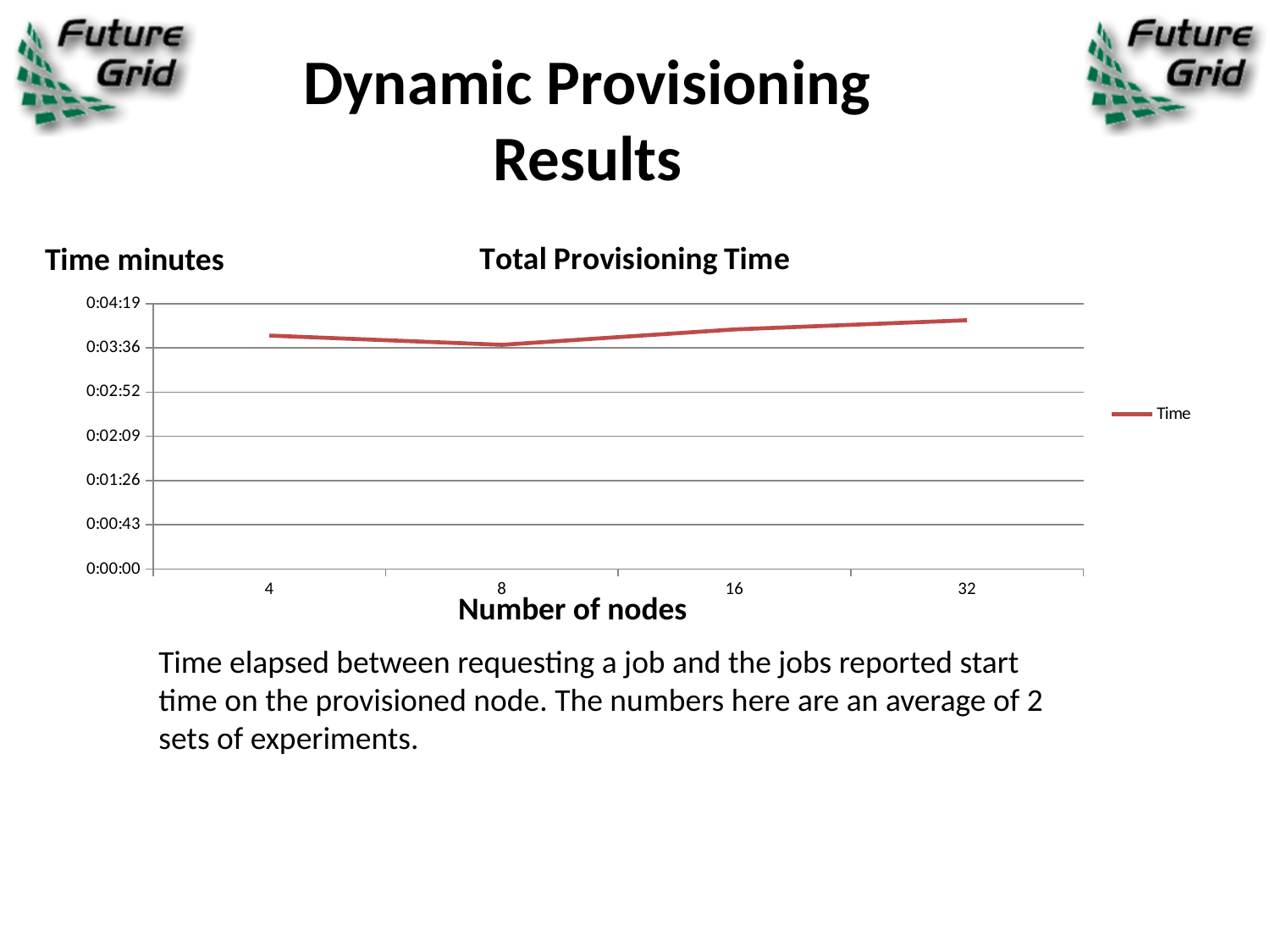
What is the title of the chart? Total Provisioning Time Which number of nodes has the lowest total provisioning time? 8 How many node counts are plotted along the x axis? 4 Which has a larger provisioning time, 16 nodes or 8 nodes? 16 nodes Which number of nodes has the highest total provisioning time? 32 Is the provisioning time for 8 nodes greater or less than 0:02:52? greater Is the provisioning time for 32 nodes greater or less than 0:03:36? greater How many series does the legend list? 1 Which has a larger provisioning time, 32 nodes or 8 nodes? 32 nodes What is the name of the series shown in the legend? Time What type of chart is shown on the slide? line chart Does the provisioning time rise or fall from 8 nodes to 32 nodes? rise